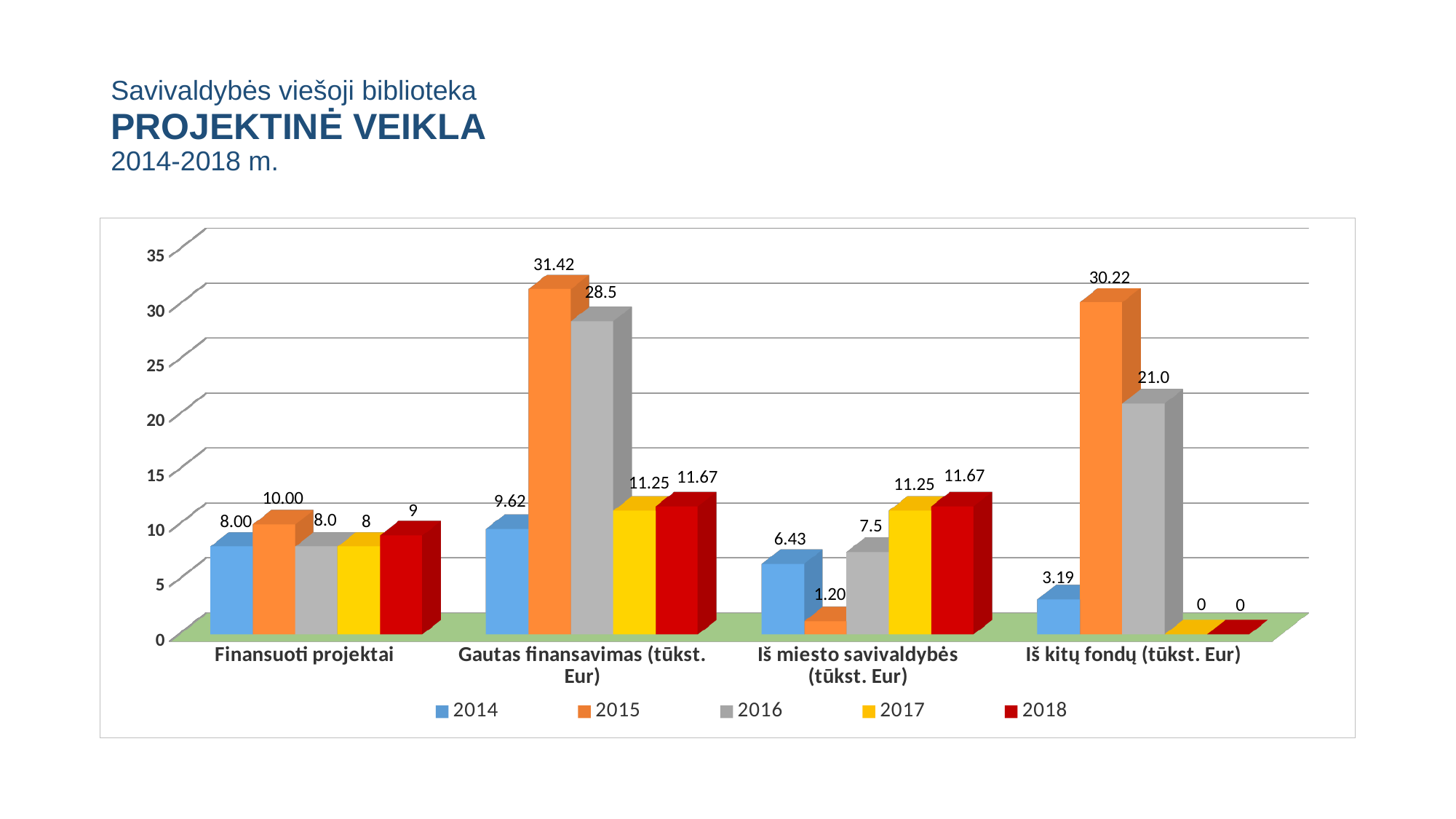
What is the value for 2018 in the 'Finansuoti projektai' category? 9 What is the value for 2015 in the 'Gautas finansavimas (tūkst. Eur)' category? 31.42 Which year has the highest value in the 'Gautas finansavimas (tūkst. Eur)' category? 2015 Which year has the lowest value in the 'Iš miesto savivaldybės (tūkst. Eur)' category? 2015 What is the value for 2017 in the 'Iš kitų fondų (tūkst. Eur)' category? 0 Which is larger in the 'Iš miesto savivaldybės (tūkst. Eur)' category: the 2016 value or the 2017 value? 2017 What is the value for 2016 in the 'Iš kitų fondų (tūkst. Eur)' category? 21.0 What kind of chart is shown on the slide? bar chart How many series does the legend list? 5 How many categories are shown on the x axis? 4 What is the value for 2014 in the 'Iš miesto savivaldybės (tūkst. Eur)' category? 6.43 What is the difference between the 2015 and 2016 values in the 'Iš kitų fondų (tūkst. Eur)' category? 9.22